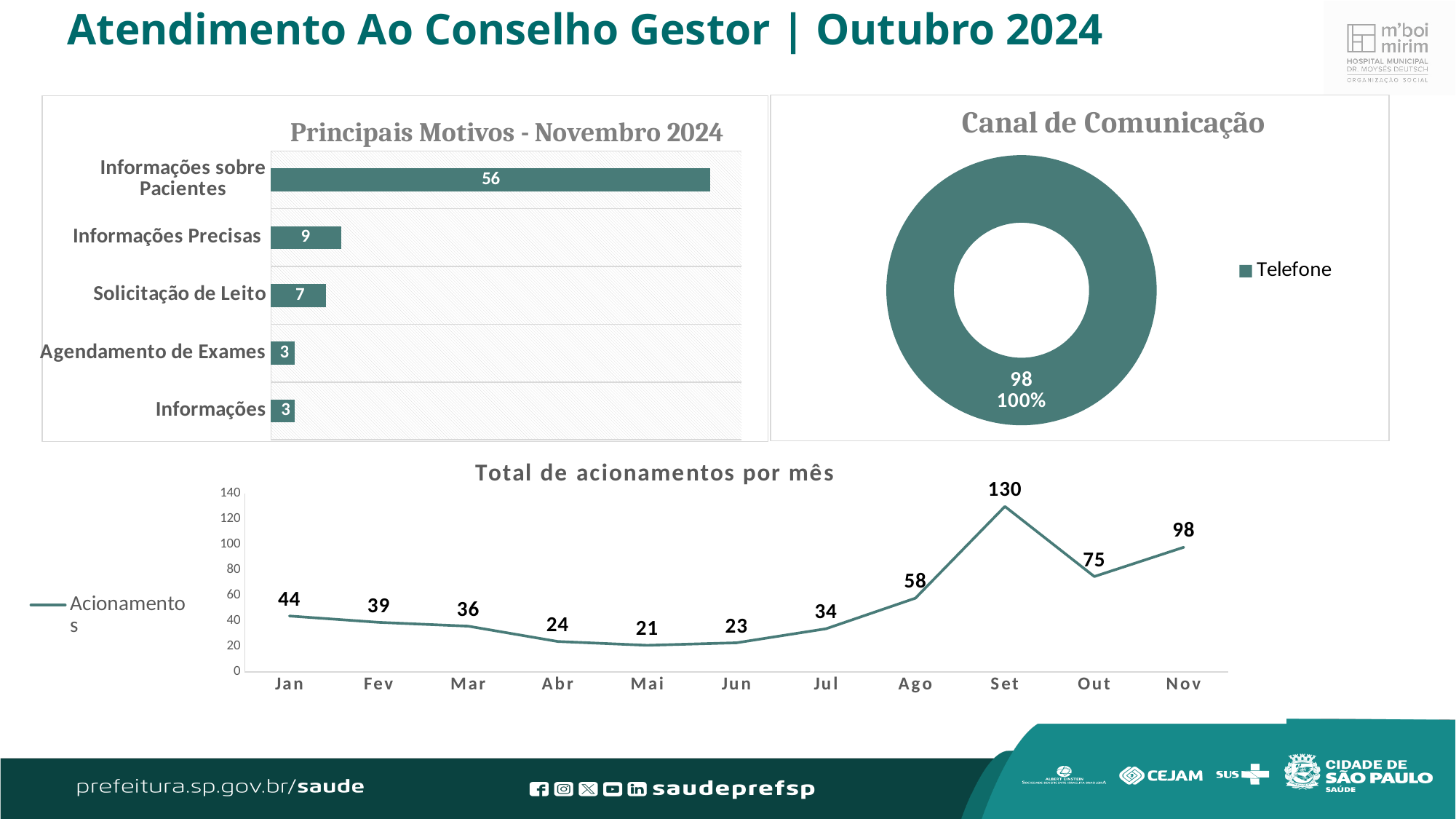
In the 'Canal de Comunicação' chart, what share does Telefone have? 100% In the 'Total de acionamentos por mês' chart, what is the difference between Set and Out? 55 In the 'Principais Motivos - Novembro 2024' chart, what is the difference between Informações Precisas and Solicitação de Leito? 2 In the 'Principais Motivos - Novembro 2024' chart, which category has the highest value? Informações sobre Pacientes In the 'Total de acionamentos por mês' chart, is the value for Nov larger than the value for Ago? Yes What kind of chart is 'Principais Motivos - Novembro 2024'? Bar chart In the 'Canal de Comunicação' chart, what value is shown for Telefone? 98 In the 'Principais Motivos - Novembro 2024' chart, what is the value for Informações sobre Pacientes? 56 In the 'Total de acionamentos por mês' chart, what is the value for Set? 130 In the 'Principais Motivos - Novembro 2024' chart, how many categories are shown? 5 In the 'Total de acionamentos por mês' chart, how many months are plotted? 11 In the 'Total de acionamentos por mês' chart, which month has the lowest value? Mai